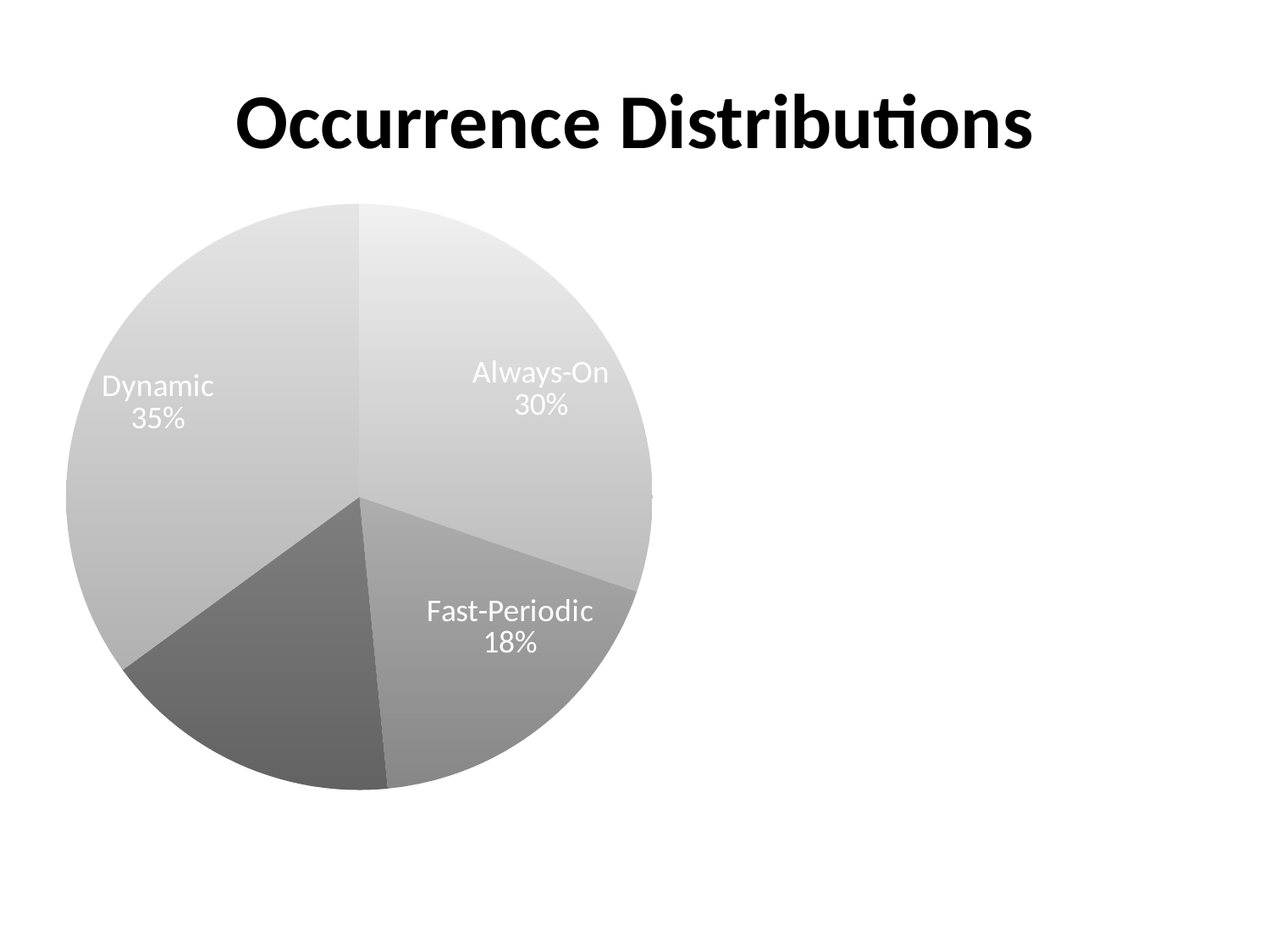
What type of chart is shown on the slide? pie chart Which is larger, the Dynamic slice or the Always-On slice? Dynamic What is the difference in percentage points between Dynamic and Always-On? 5% How many slices does the pie chart have? 4 Which labeled category has the largest slice of the pie? Dynamic What percentage is shown for Always-On? 30% What is the difference in percentage points between Always-On and Fast-Periodic? 12% What is the difference in percentage points between Dynamic and Fast-Periodic? 17% What is the title of the chart? Occurrence Distributions Which is larger, the Always-On slice or the Fast-Periodic slice? Always-On What percentage is shown for Fast-Periodic? 18% What share of the pie does the Dynamic slice represent? 35%